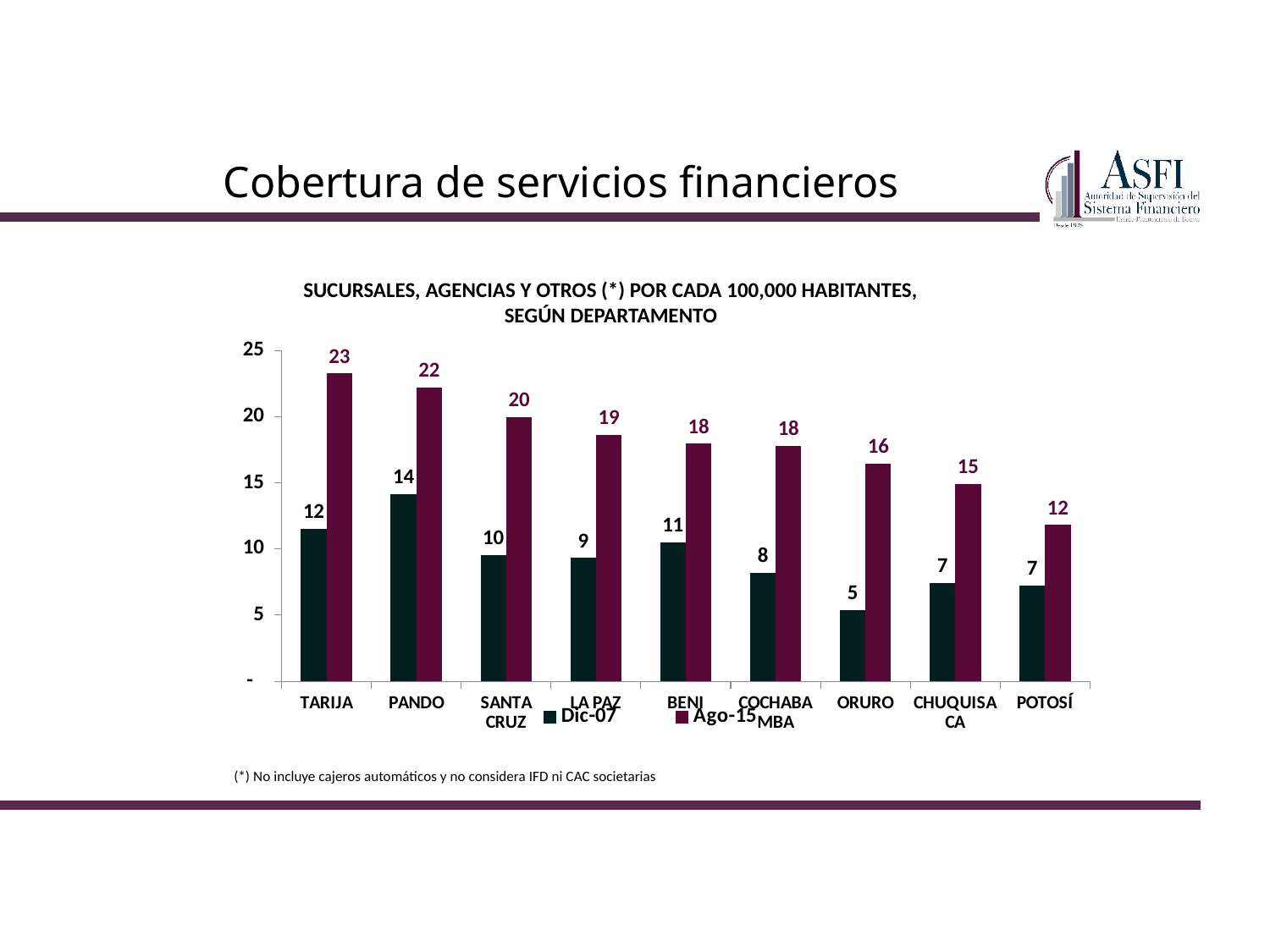
How many series does the legend list? 2 Which department has the highest Ago-15 value? TARIJA What kind of chart is shown on the slide? Bar chart What is the difference between the Ago-15 and Dic-07 values for SANTA CRUZ? 10 What is the Dic-07 value for PANDO? 14 How many departments are shown on the x axis? 9 What is the Ago-15 value for CHUQUISACA? 15 Do the Ago-15 values rise or fall from TARIJA to POTOSÍ along the x axis? Fall Which department has the lowest Dic-07 value? ORURO What is the Dic-07 value for ORURO? 5 Which is larger for POTOSÍ, the Dic-07 value or the Ago-15 value? Ago-15 What is the Ago-15 value for TARIJA? 23